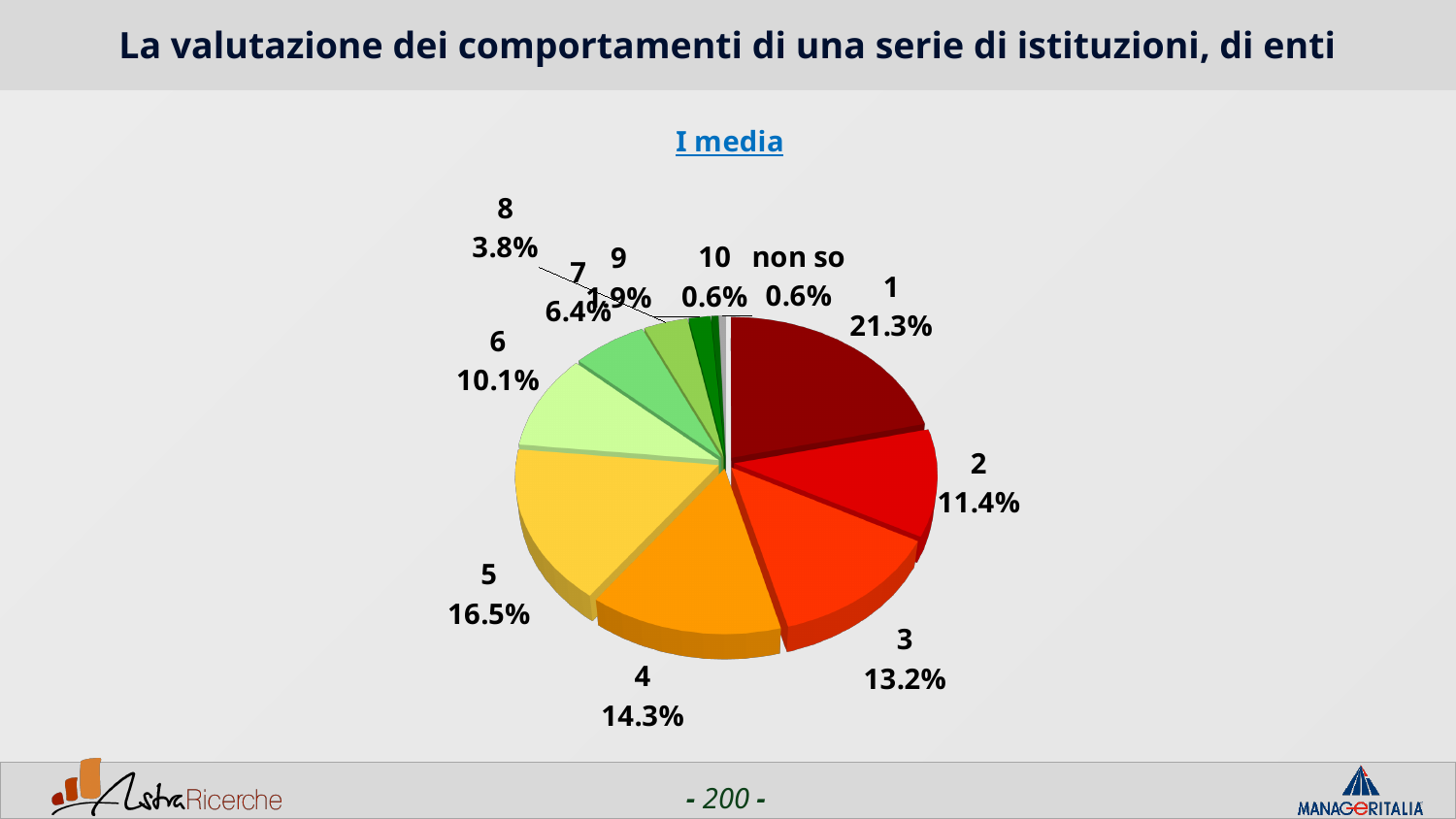
Which category has the largest slice of the pie? 1 What percentage is shown for category 8? 3.8% What percentage is shown for category 5? 16.5% What kind of chart is shown on the slide? pie chart What is the difference between the percentages for category 1 and category 2? 9.9% Which is larger, the slice for category 4 or the slice for category 3? 4 What is the combined share of categories 9, 10 and 'non so'? 3.1% What percentage is shown for the 'non so' slice? 0.6% What percentage is shown for category 1? 21.3% How many slices does the pie chart have? 11 Which category has the smallest slice among categories 1 to 9? 9 What is the title of the chart? I media